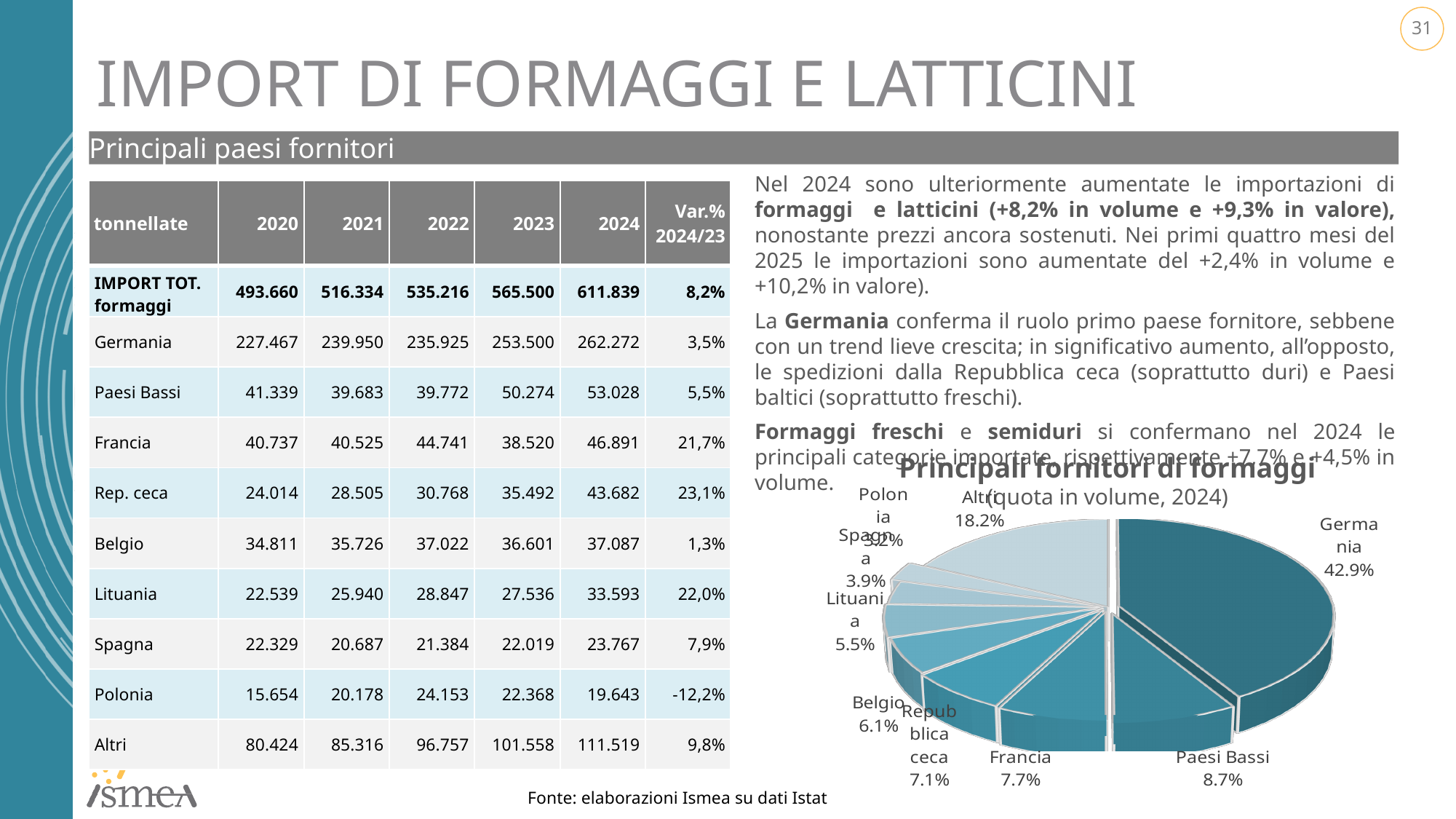
What is the title of the chart on the slide? Principali fornitori di formaggi (quota in volume, 2024) What is the share for Lituania in the pie chart? 5.5% How many slices does the pie chart have? 9 What is the share shown for Paesi Bassi in the pie chart? 8.7% What type of chart is shown on the slide? Pie chart Which country has the largest slice in the pie chart? Germania By how many percentage points does Germania's share exceed that of Paesi Bassi in the pie chart? 34.2 percentage points Which has a larger share in the pie chart, Francia or Belgio? Francia What percentage is labelled for Francia in the pie chart? 7.7% What share does the 'Altri' slice represent in the pie chart? 18.2% What share of the pie chart does Germania hold? 42.9% What is the share for Belgio in the pie chart? 6.1%